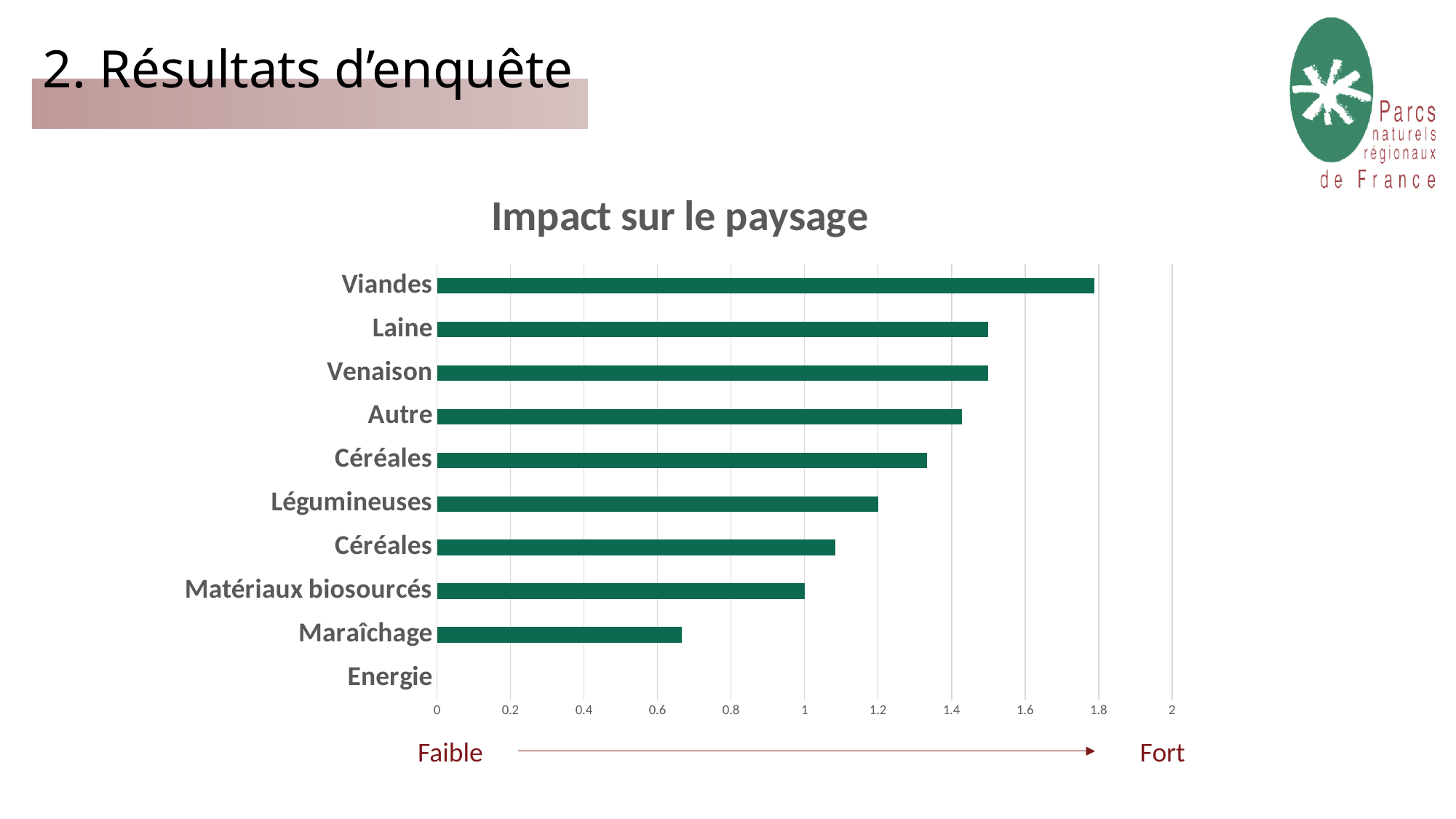
What is the title of the chart? Impact sur le paysage What labels are shown at the two ends of the arrow below the horizontal axis? Faible and Fort Which category has the highest value in the chart? Viandes What kind of chart is shown on the slide? bar chart What is the value for Légumineuses? 1.2 What is the value for Matériaux biosourcés? 1 Which category has the lowest value in the chart? Energie How many categories are listed on the chart's vertical axis? 10 Is the value for Maraîchage greater or less than 0.8? less Which is larger, the value for Viandes or the value for Laine? Viandes Is the value for Viandes greater or less than 1.6? greater Is the value for Laine greater or less than 1.4? greater